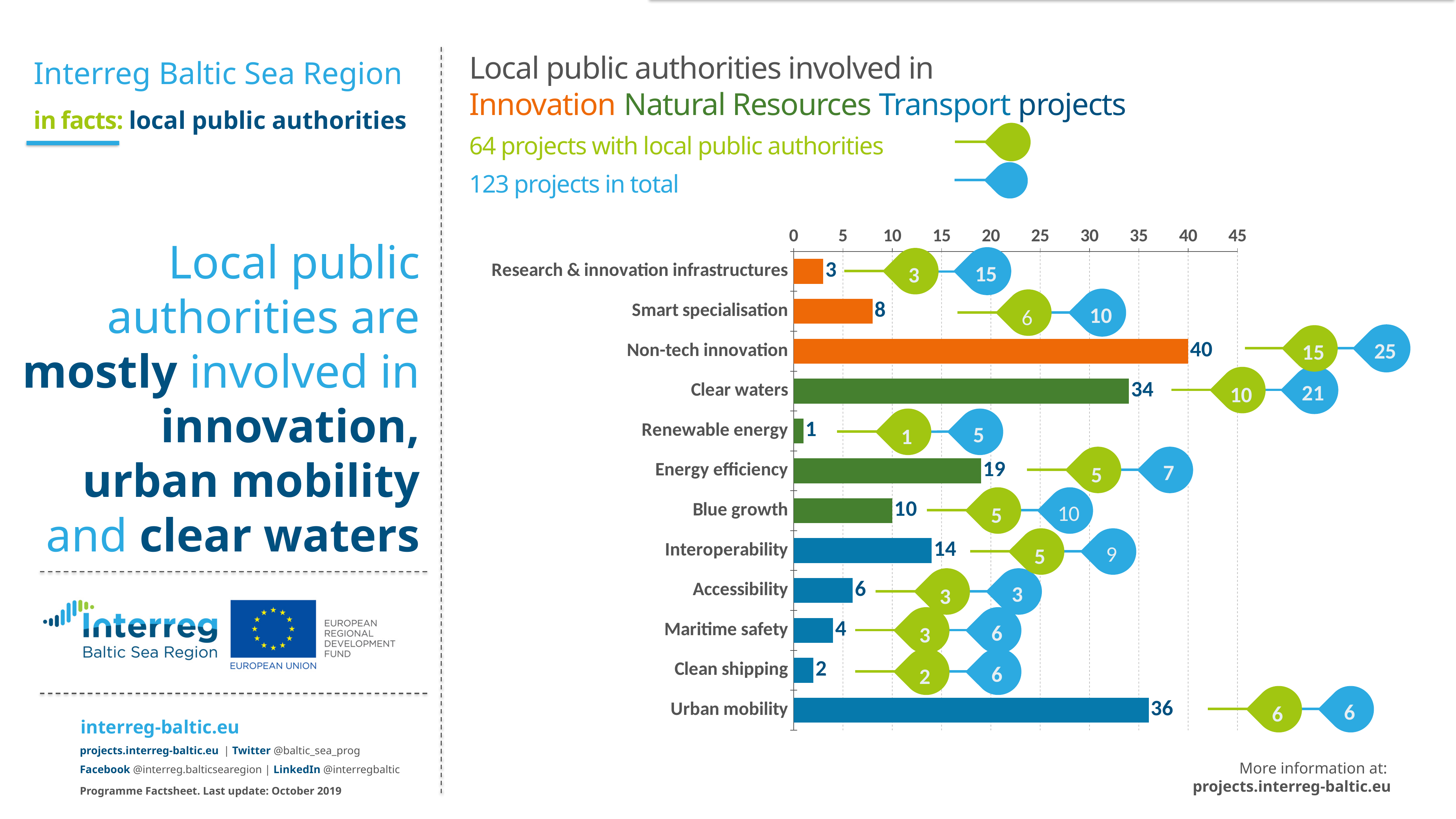
Which has a larger bar value, Interoperability or Blue growth? Interoperability How many projects in total are marked for Non-tech innovation (blue marker)? 25 Which category has the lowest bar value? Renewable energy Which category has the highest bar value? Non-tech innovation What is the difference between the bar values for Non-tech innovation and Clear waters? 6 What is the bar value for Urban mobility? 36 What kind of chart is shown on the slide? Bar chart What is the bar value for Non-tech innovation? 40 What is the highest value shown on the horizontal axis? 45 How many projects with local public authorities are marked for Clear waters (green marker)? 10 What is the bar value for Energy efficiency? 19 How many categories are shown on the chart? 12